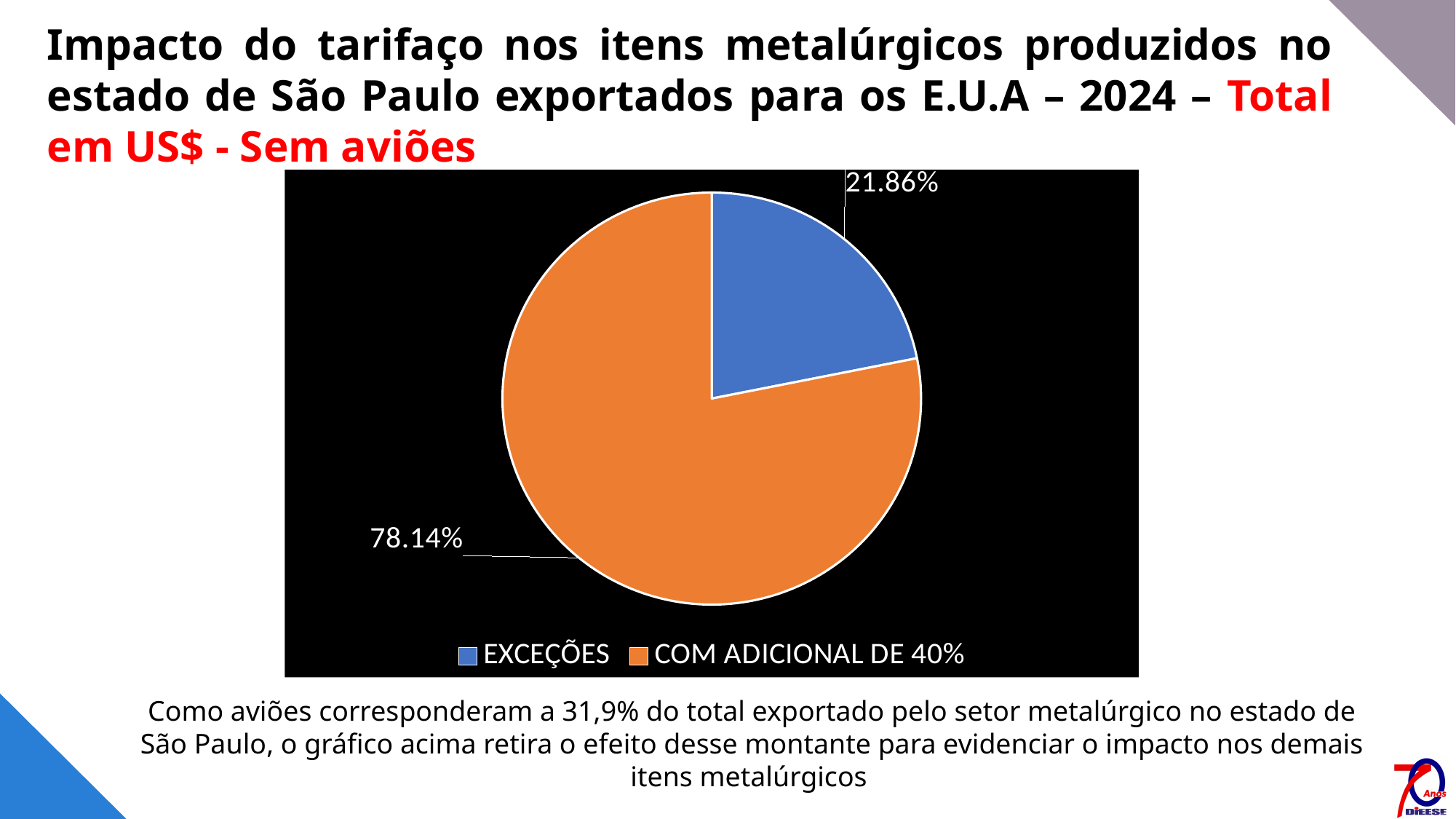
Which is larger, the EXCEÇÕES slice or the COM ADICIONAL DE 40% slice? COM ADICIONAL DE 40% Is the share for EXCEÇÕES greater or less than 25%? less What share of the pie does EXCEÇÕES represent? 21.86% Which slice of the pie is the largest? COM ADICIONAL DE 40% What colour is the EXCEÇÕES slice? blue How many slices does the pie chart have? 2 What share of the pie does COM ADICIONAL DE 40% represent? 78.14% What is the difference in percentage points between the COM ADICIONAL DE 40% slice and the EXCEÇÕES slice? 56.28 What kind of chart is shown on the slide? pie chart Which slice of the pie is the smallest? EXCEÇÕES What colour is the COM ADICIONAL DE 40% slice? orange How many entries does the legend list? 2